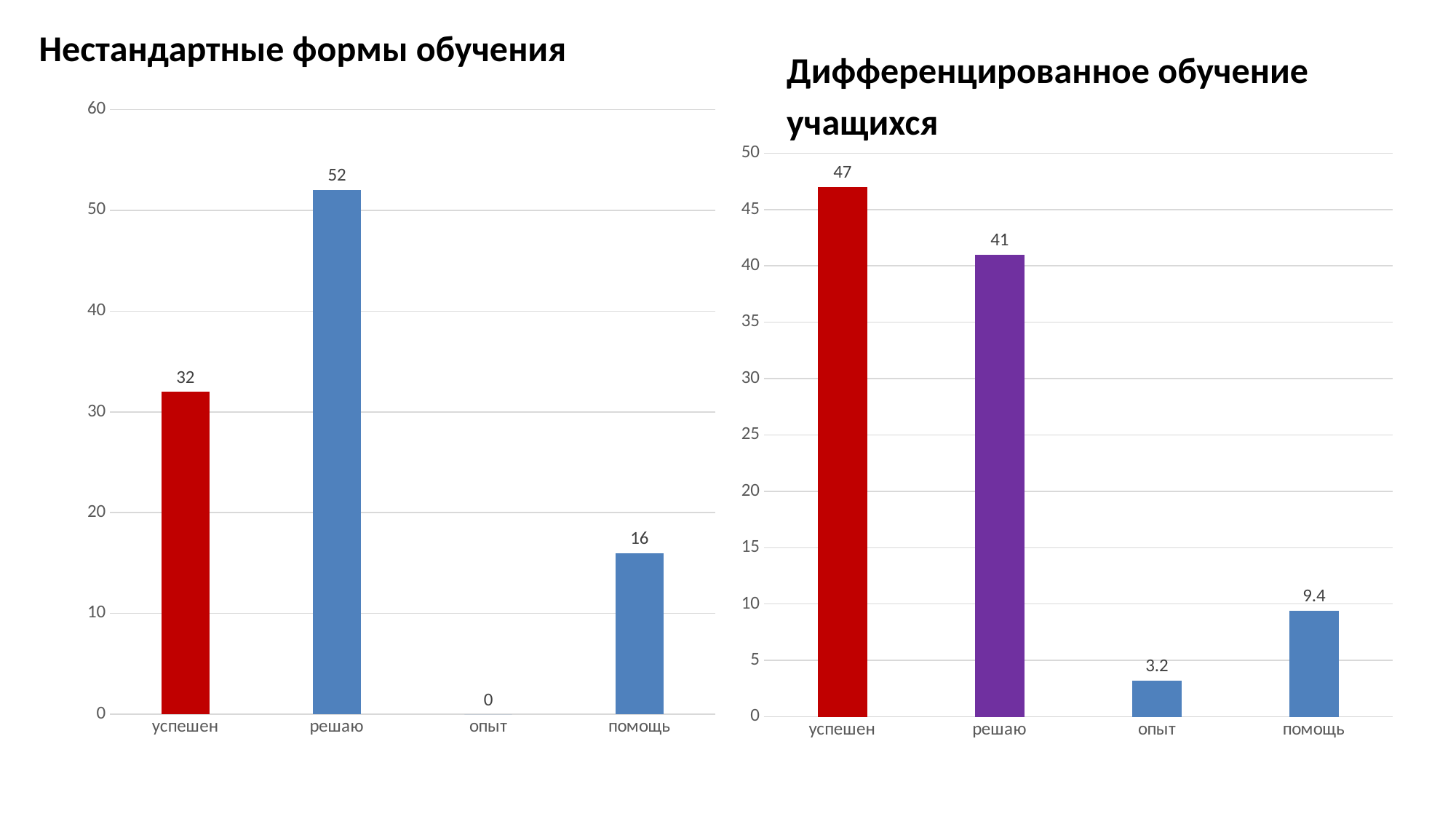
In the chart titled 'Дифференцированное обучение учащихся', what colour is the bar for 'решаю'? purple What kind of chart is the chart titled 'Нестандартные формы обучения'? bar chart In the chart titled 'Дифференцированное обучение учащихся', which is larger, the value for 'успешен' or the value for 'решаю'? успешен In the chart titled 'Нестандартные формы обучения', what is the value for 'решаю'? 52 In the chart titled 'Дифференцированное обучение учащихся', what is the difference between the values for 'успешен' and 'решаю'? 6 In the chart titled 'Дифференцированное обучение учащихся', which category has the highest value? успешен In the chart titled 'Нестандартные формы обучения', how many categories are shown on the x axis? 4 In the chart titled 'Дифференцированное обучение учащихся', what is the value for 'опыт'? 3.2 In the chart titled 'Нестандартные формы обучения', which category has the highest value? решаю In the chart titled 'Нестандартные формы обучения', what is the difference between the values for 'решаю' and 'успешен'? 20 In the chart titled 'Нестандартные формы обучения', which category has the lowest value? опыт In the chart titled 'Дифференцированное обучение учащихся', what is the value for 'помощь'? 9.4